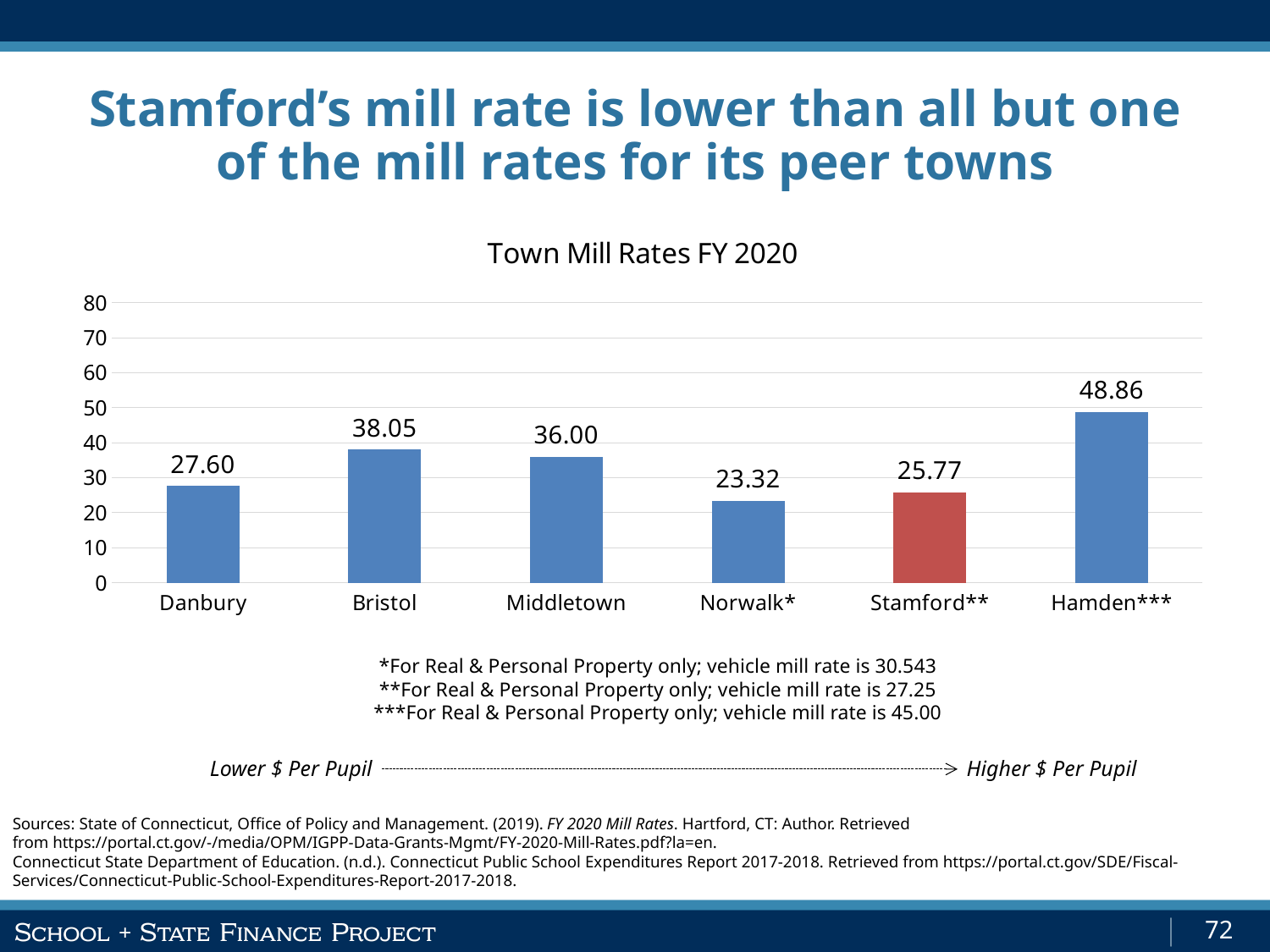
What is the mill rate for Danbury? 27.60 Which has a higher mill rate, Danbury or Stamford**? Danbury What is the title of the chart? Town Mill Rates FY 2020 What type of chart is shown on the slide? Bar chart What is the difference between the mill rates of Hamden*** and Stamford**? 23.09 How many towns are shown in the chart? 6 Is the mill rate for Bristol greater or less than 30? greater What is the difference between the mill rates of Bristol and Middletown? 2.05 Which town has the lowest mill rate? Norwalk* What is the mill rate for Stamford**? 25.77 Which town has the highest mill rate? Hamden*** What is the mill rate for Hamden***? 48.86